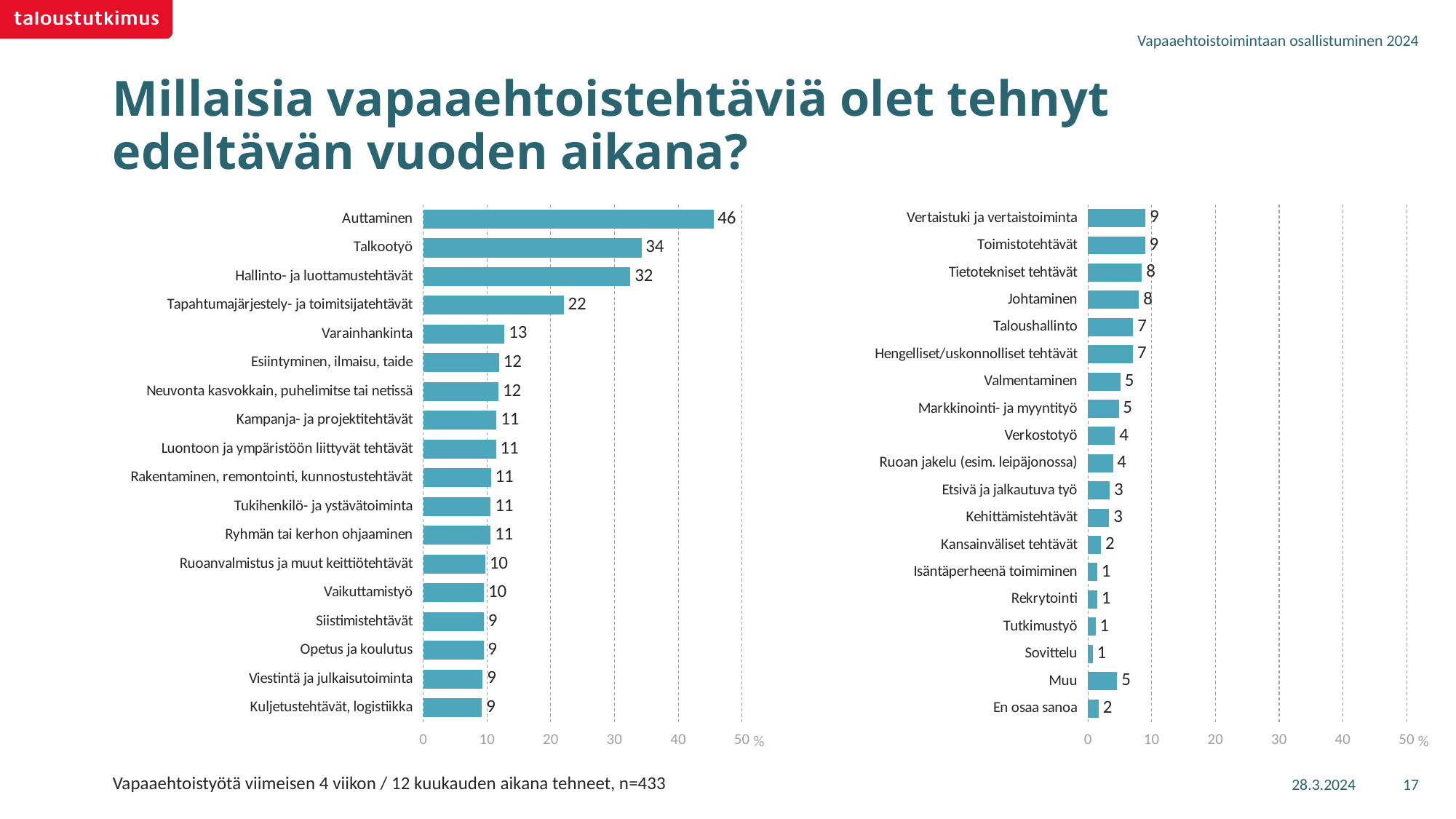
On the left chart, what is the value for Tapahtumajärjestely- ja toimitsijatehtävät? 22 What type of chart is used on the left side of the slide? Bar chart How many categories are shown on the right chart? 19 On the left chart, what is the value for Auttaminen? 46 On the left chart, which is larger, Varainhankinta or Vaikuttamistyö? Varainhankinta On the left chart, is the value for Auttaminen greater or less than 40? greater On the left chart, which category has the highest value? Auttaminen How many categories are shown on the left chart? 18 On the right chart, what is the value for Muu? 5 On the right chart, what is the value for Johtaminen? 8 On the left chart, what is the difference between Talkootyö and Hallinto- ja luottamustehtävät? 2 On the right chart, which category has the lowest value among Kansainväliset tehtävät and Sovittelu? Sovittelu